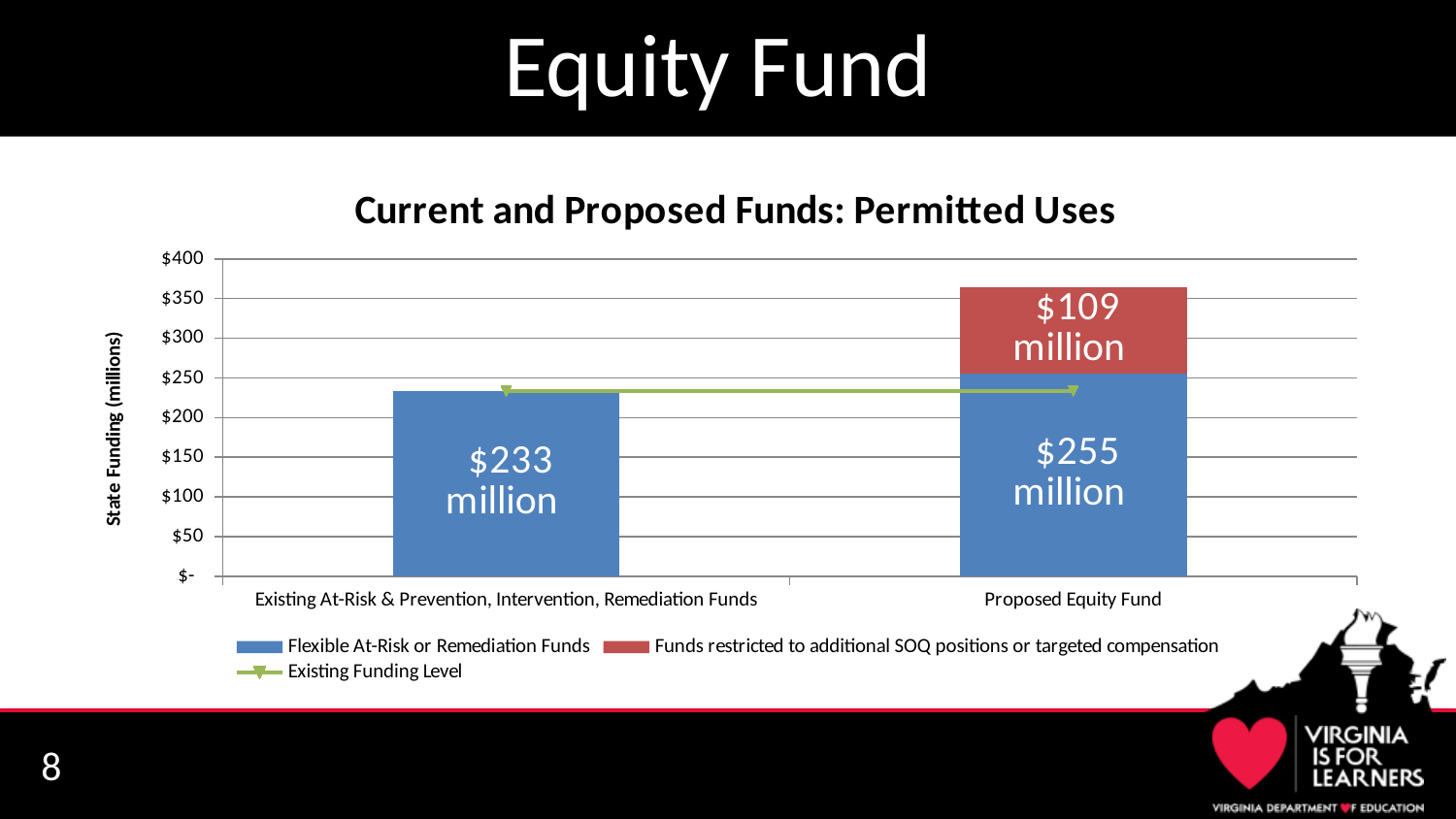
What is the difference between the Flexible At-Risk or Remediation Funds values for the Proposed Equity Fund and the Existing At-Risk & Prevention, Intervention, Remediation Funds? $22 million What is the total of the Proposed Equity Fund stacked bar? $364 million What is the value of the Flexible At-Risk or Remediation Funds segment for the Proposed Equity Fund? $255 million What is the label of the y axis? State Funding (millions) Is the total for the Proposed Equity Fund bar greater or less than $350? greater How many categories are shown on the x axis? 2 What is the value of the Flexible At-Risk or Remediation Funds for the Existing At-Risk & Prevention, Intervention, Remediation Funds bar? $233 million How many series does the legend list? 3 What is the title of the chart? Current and Proposed Funds: Permitted Uses What is the value of the Funds restricted to additional SOQ positions or targeted compensation segment for the Proposed Equity Fund? $109 million What type of chart is shown on the slide? Stacked bar chart Which category has the taller bar overall? Proposed Equity Fund